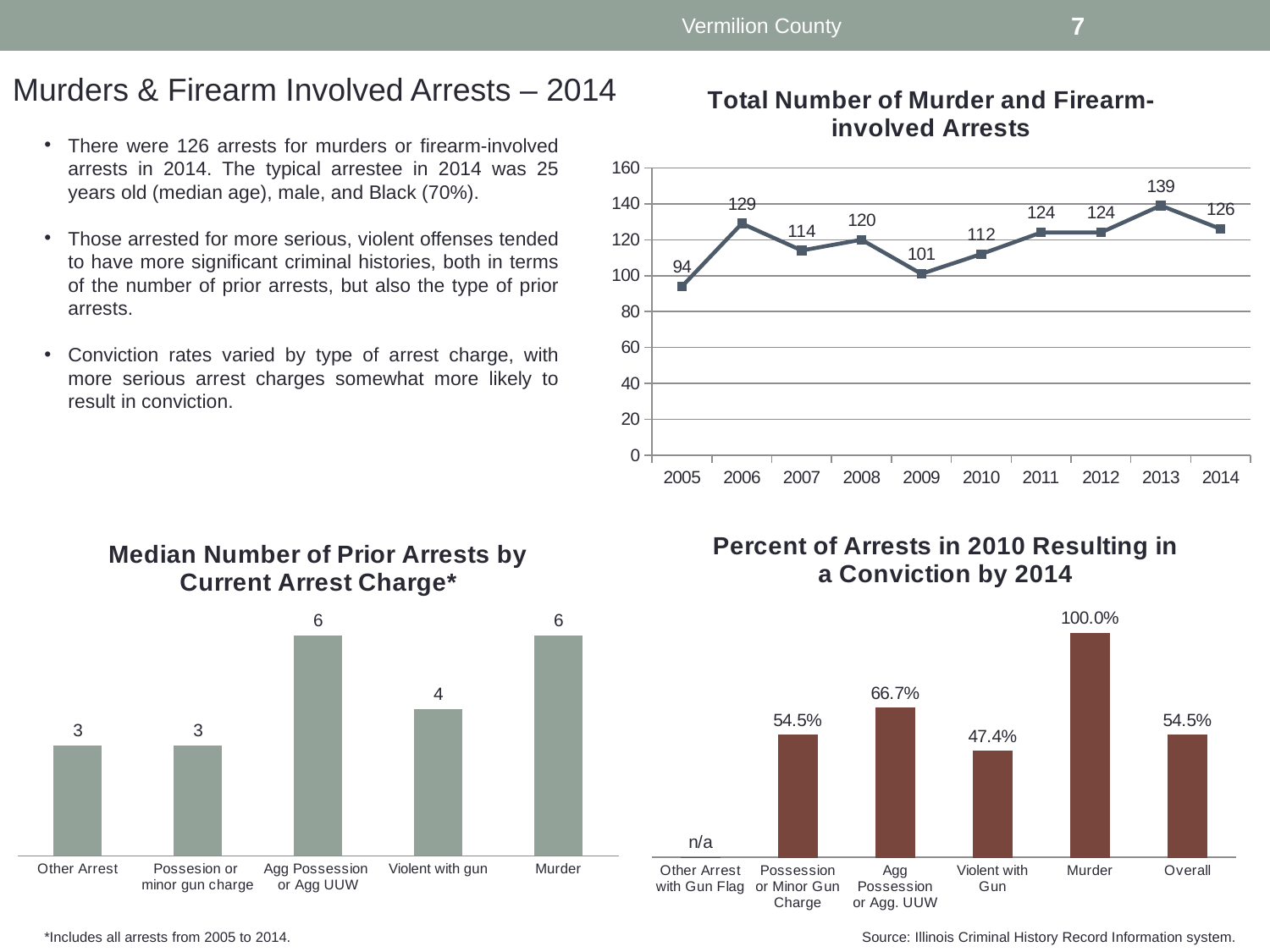
In the 'Total Number of Murder and Firearm-involved Arrests' chart, what was the value for 2013? 139 In the 'Percent of Arrests in 2010 Resulting in a Conviction by 2014' chart, which category has the lowest percentage among those with a value shown? Violent with Gun In the 'Total Number of Murder and Firearm-involved Arrests' chart, how many years are plotted? 10 In the 'Total Number of Murder and Firearm-involved Arrests' chart, which year had the lowest number of arrests? 2005 In the 'Median Number of Prior Arrests by Current Arrest Charge' chart, how many categories are shown? 5 In the 'Median Number of Prior Arrests by Current Arrest Charge' chart, what is the value for Violent with gun? 4 In the 'Median Number of Prior Arrests by Current Arrest Charge' chart, which is larger: Agg Possession or Agg UUW or Violent with gun? Agg Possession or Agg UUW In the 'Total Number of Murder and Firearm-involved Arrests' chart, what is the difference between the 2013 and 2014 values? 13 In the 'Total Number of Murder and Firearm-involved Arrests' chart, did the value rise or fall from 2008 to 2009? Fall What type of chart is the 'Total Number of Murder and Firearm-involved Arrests' chart? Line chart In the 'Percent of Arrests in 2010 Resulting in a Conviction by 2014' chart, what is the value for Murder? 100.0% In the 'Percent of Arrests in 2010 Resulting in a Conviction by 2014' chart, what is the difference between Agg Possession or Agg. UUW and Overall? 12.2%